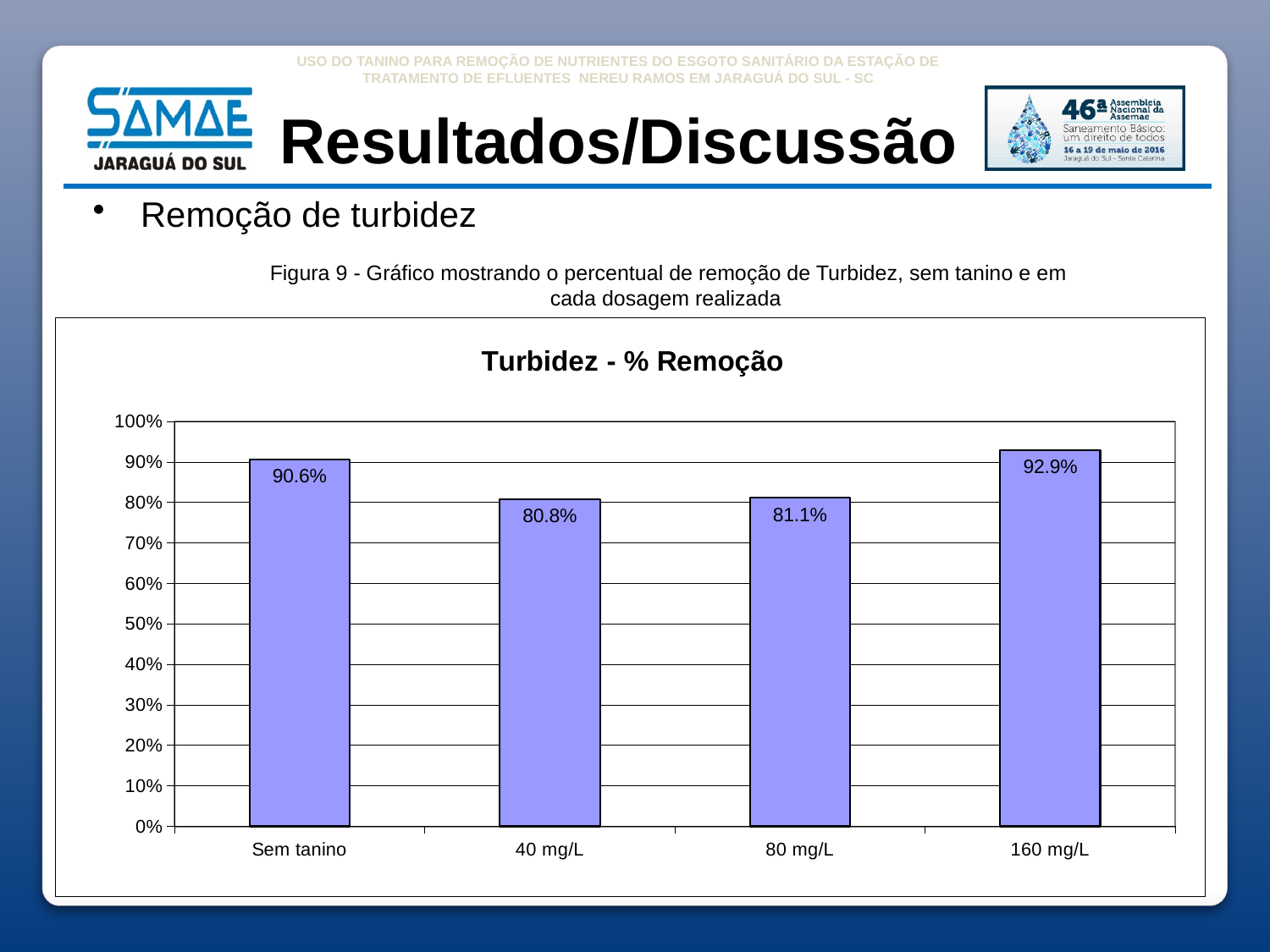
What is the turbidity removal percentage at the 40 mg/L dosage? 80.8% What type of chart is shown on the slide? Bar chart What is the turbidity removal percentage at the 80 mg/L dosage? 81.1% What is the difference in removal percentage between 'Sem tanino' and 80 mg/L? 9.5% What is the difference in removal percentage between 160 mg/L and 40 mg/L? 12.1% Which has a higher removal percentage, 'Sem tanino' or 160 mg/L? 160 mg/L What is the turbidity removal percentage for 'Sem tanino'? 90.6% How many categories are shown on the x axis of the chart? 4 What is the title of the chart? Turbidez - % Remoção Which category has the lowest turbidity removal percentage? 40 mg/L Which category has the highest turbidity removal percentage? 160 mg/L What is the turbidity removal percentage at the 160 mg/L dosage? 92.9%